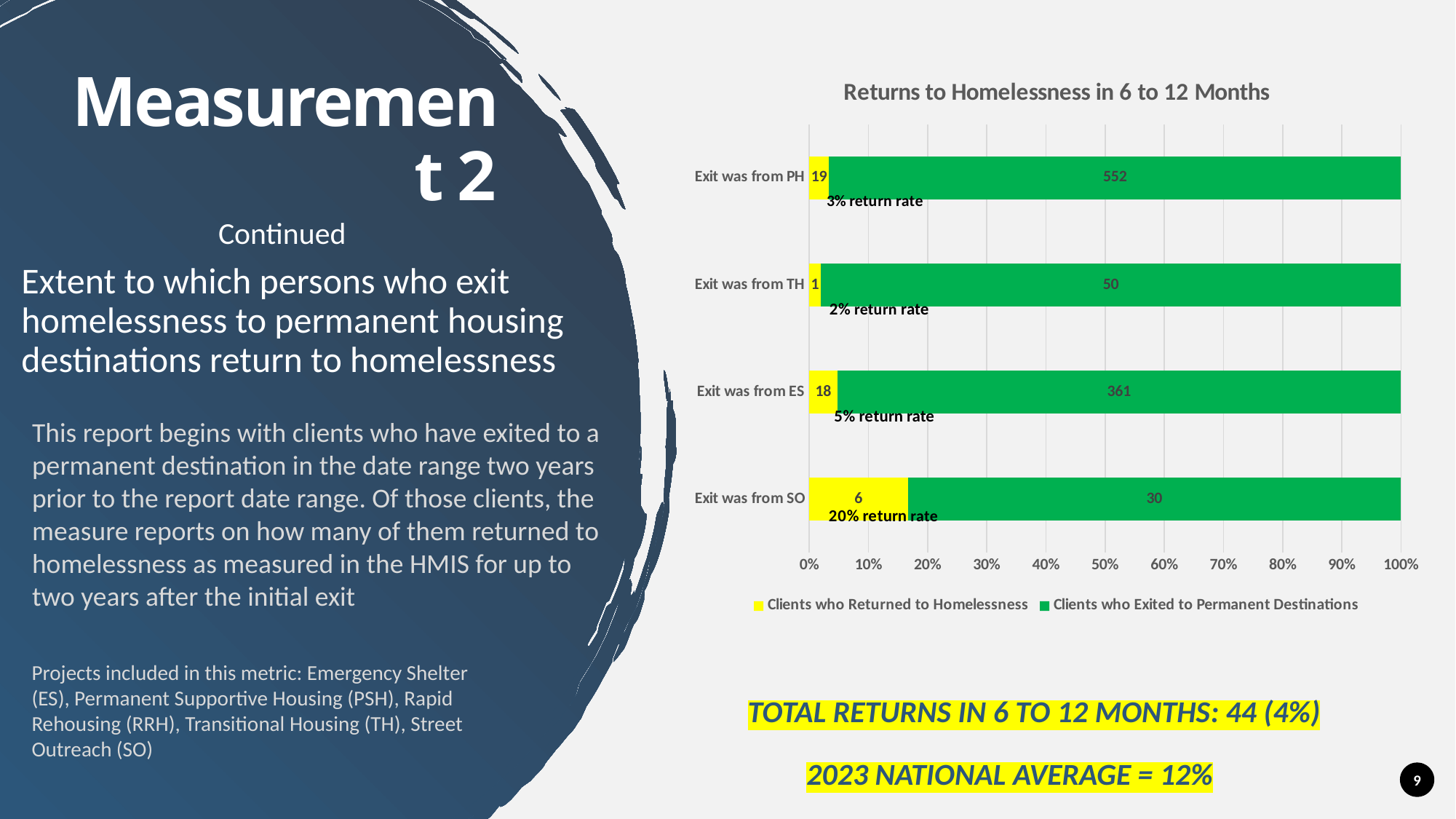
What is the difference between the Clients who Exited to Permanent Destinations for 'Exit was from PH' and 'Exit was from ES'? 191 What return rate is labelled for 'Exit was from SO'? 20% return rate What type of chart is shown on the slide? Stacked bar chart What is the title of the chart? Returns to Homelessness in 6 to 12 Months What colour represents Clients who Returned to Homelessness in the chart? Yellow How many categories are plotted on the chart? 4 Which category has the lowest number of Clients who Returned to Homelessness? Exit was from TH Which category has the highest number of Clients who Exited to Permanent Destinations? Exit was from PH Which has more Clients who Returned to Homelessness: 'Exit was from PH' or 'Exit was from SO'? Exit was from PH How many Clients who Exited to Permanent Destinations are shown for 'Exit was from ES'? 361 How many series does the chart legend list? 2 How many Clients who Returned to Homelessness are shown for 'Exit was from PH'? 19